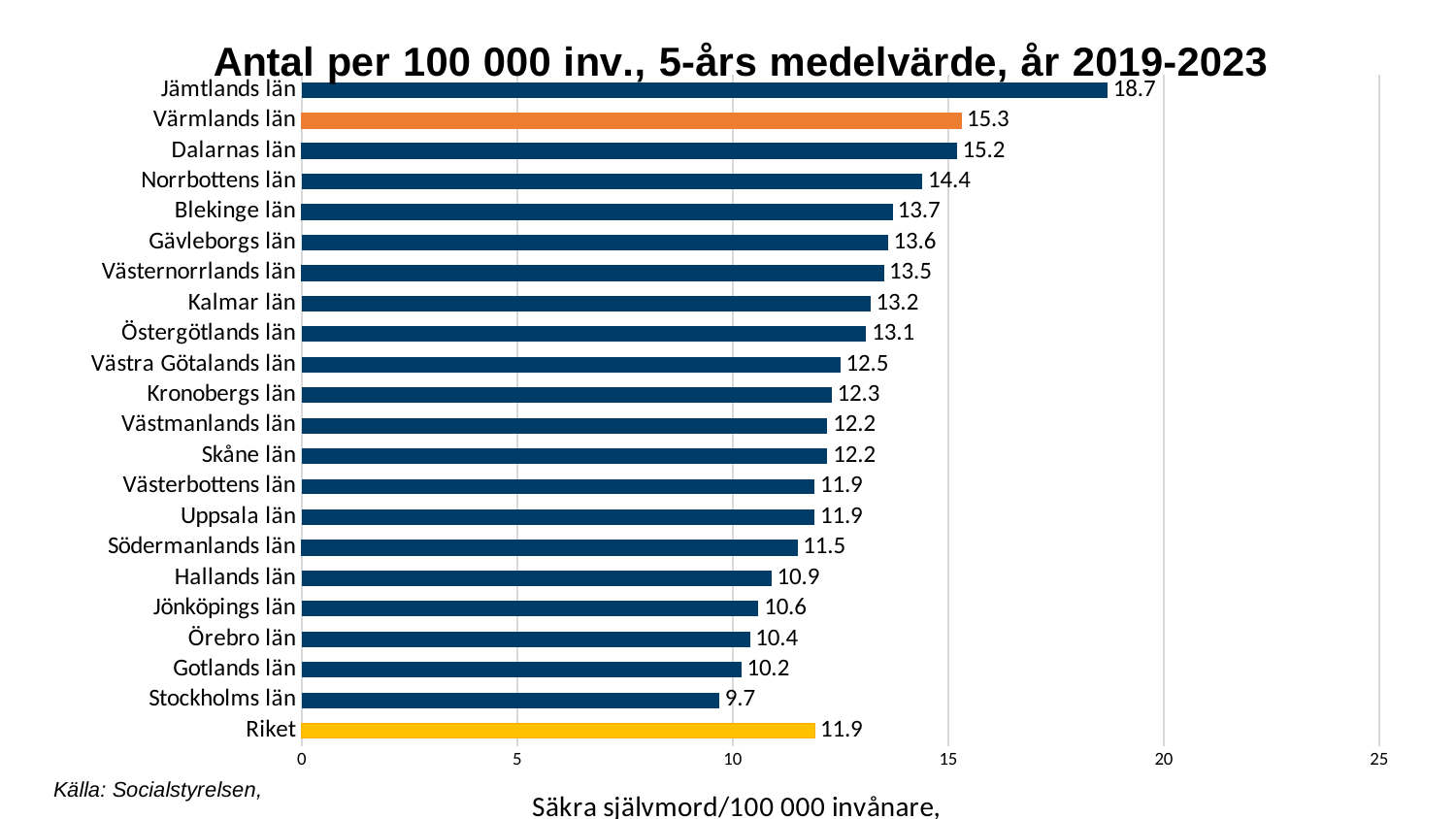
What is the value for Riket? 11.9 What is the title of the chart? Antal per 100 000 inv., 5-års medelvärde, år 2019-2023 Is the value for Gotlands län greater or less than 15? less What is the value for Värmlands län? 15.3 Which is larger, the value for Norrbottens län or the value for Blekinge län? Norrbottens län Which category has the highest value? Jämtlands län How many bars are shown in the chart? 22 What is the difference between the values for Jämtlands län and Värmlands län? 3.4 Which bar is coloured orange? Värmlands län Which category has the lowest value? Stockholms län What kind of chart is shown on the slide? bar chart What is the value for Stockholms län? 9.7